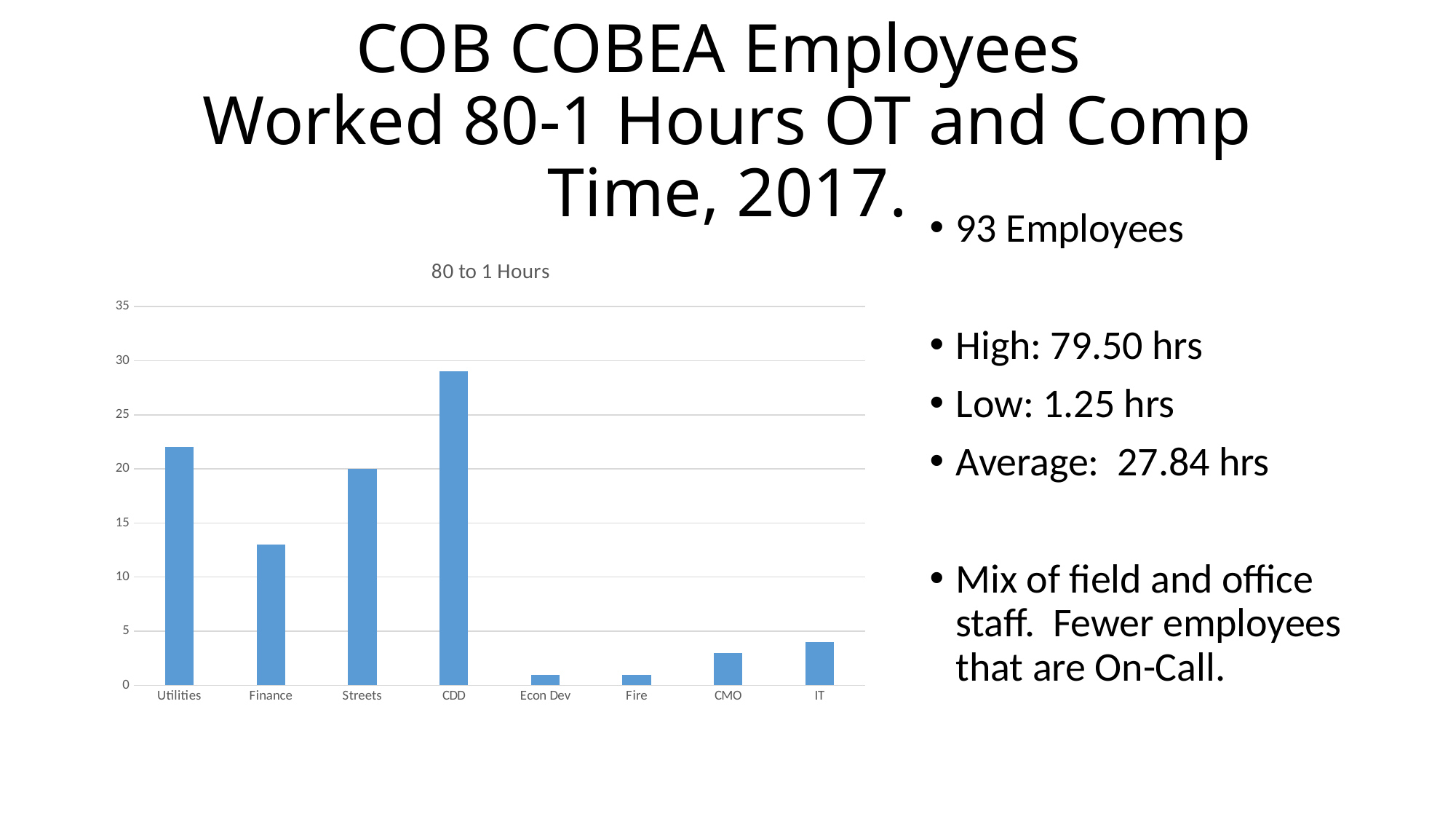
Is the value for CDD greater or less than 25? greater What is the value for Streets in the chart? 20 Is the value for Finance greater or less than 15? less Is the value for Utilities greater or less than 20? greater What is the title of the chart? 80 to 1 Hours What type of chart is shown on the slide? bar chart Which has a larger value, CMO or Streets? Streets Which category has the highest value in the chart? CDD What is the highest value shown on the y axis of the chart? 35 How many categories are shown on the x axis of the chart? 8 Which has a larger value, Utilities or Finance? Utilities